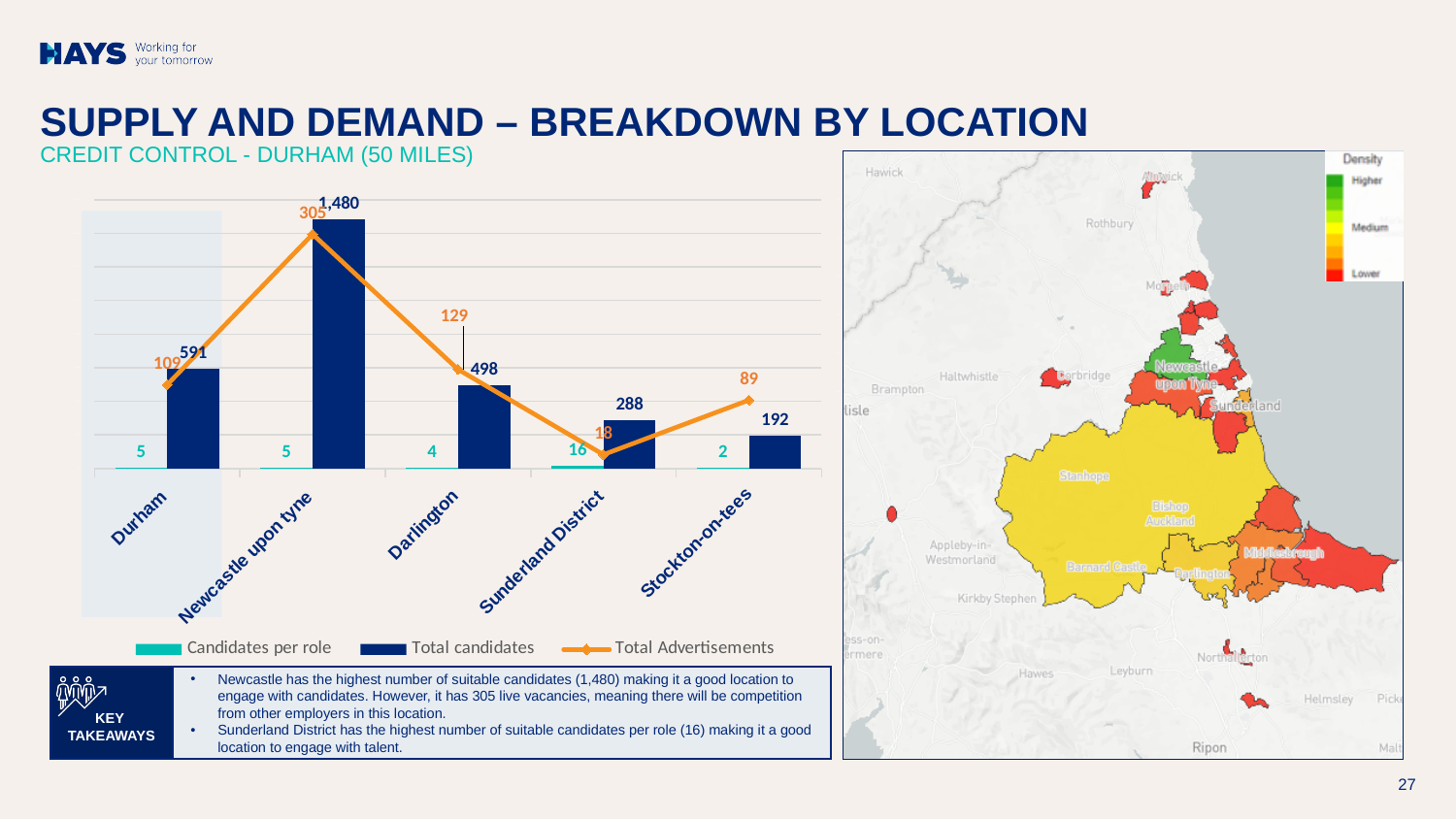
What is the difference between the Total candidates values for Durham and Darlington? 93 What is the Total Advertisements value for Darlington? 129 What is the Candidates per role value for Sunderland District? 16 Which location has the lowest Total Advertisements value? Sunderland District What is the Total candidates value for Newcastle upon tyne? 1,480 What is the Total Advertisements value for Stockton-on-tees? 89 Which is larger, the Total Advertisements value for Durham or for Stockton-on-tees? Durham How many series does the chart legend list? 3 Which location has the lowest Total candidates value? Stockton-on-tees Which series in the chart is plotted as a line rather than bars? Total Advertisements Which location has the highest Total Advertisements value? Newcastle upon tyne How many locations are shown on the x axis of the chart? 5